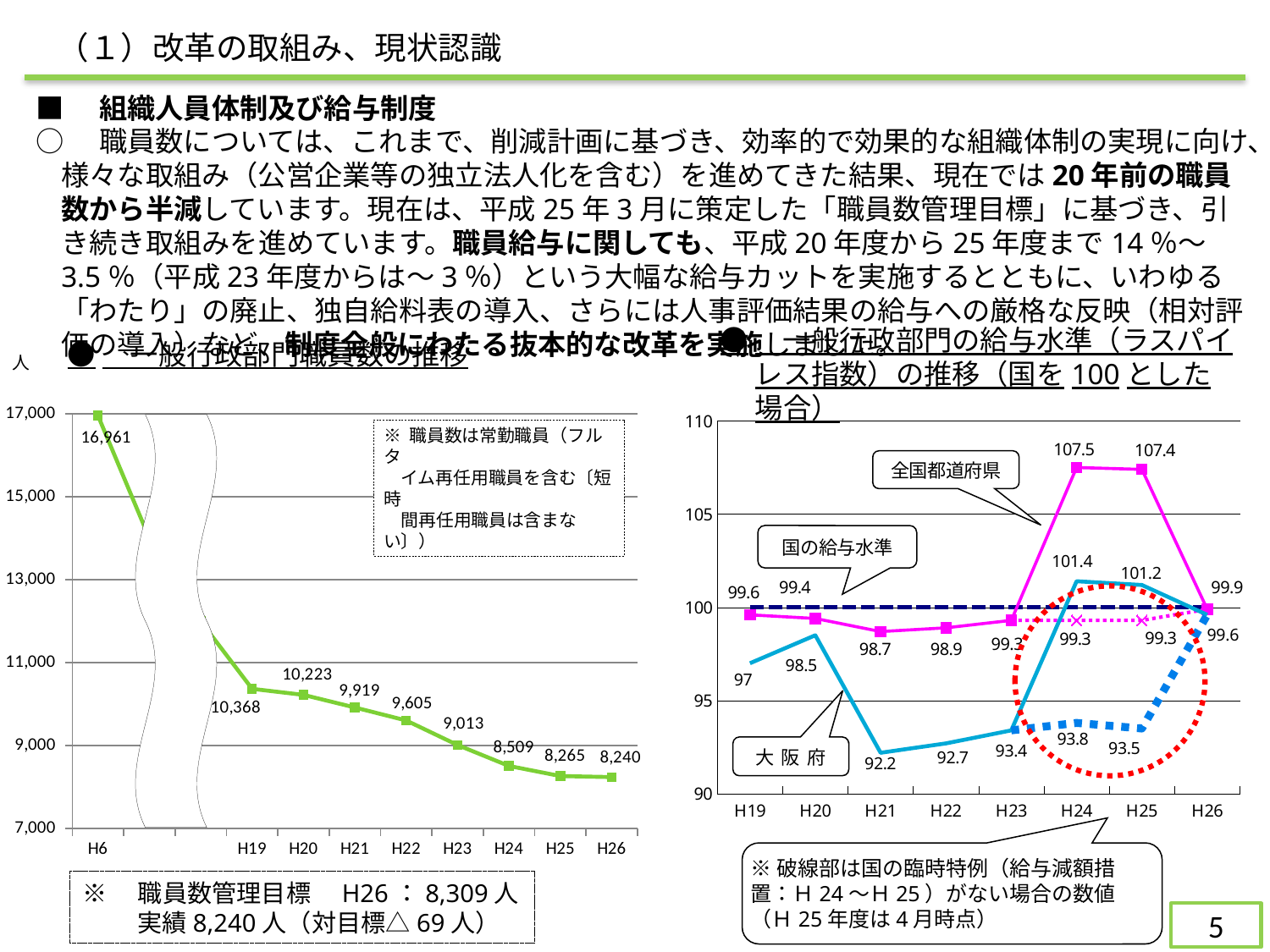
On the left chart (一般行政部門職員数の推移), do the values rise or fall from H19 to H26? fall On the left chart (一般行政部門職員数の推移), how many years are plotted on the x axis? 9 On the left chart (一般行政部門職員数の推移), what is the value for H26? 8,240 On the right chart (ラスパイレス指数の推移), which is larger for H23: 全国都道府県 or 大阪府? 全国都道府県 On the left chart (一般行政部門職員数の推移), what is the difference between the H19 value and the H26 value? 2,128 On the right chart (ラスパイレス指数の推移), what is the 大阪府 value for H21? 92.2 On the left chart (一般行政部門職員数の推移), which year has the lowest value? H26 What kind of chart is the right chart (ラスパイレス指数の推移)? line chart On the left chart (一般行政部門職員数の推移), what is the value for H6? 16,961 On the left chart (一般行政部門職員数の推移), what is the value for H22? 9,605 On the right chart (ラスパイレス指数の推移), which year has the lowest 大阪府 value? H21 On the right chart (ラスパイレス指数の推移), what is the 全国都道府県 value for H24? 107.5